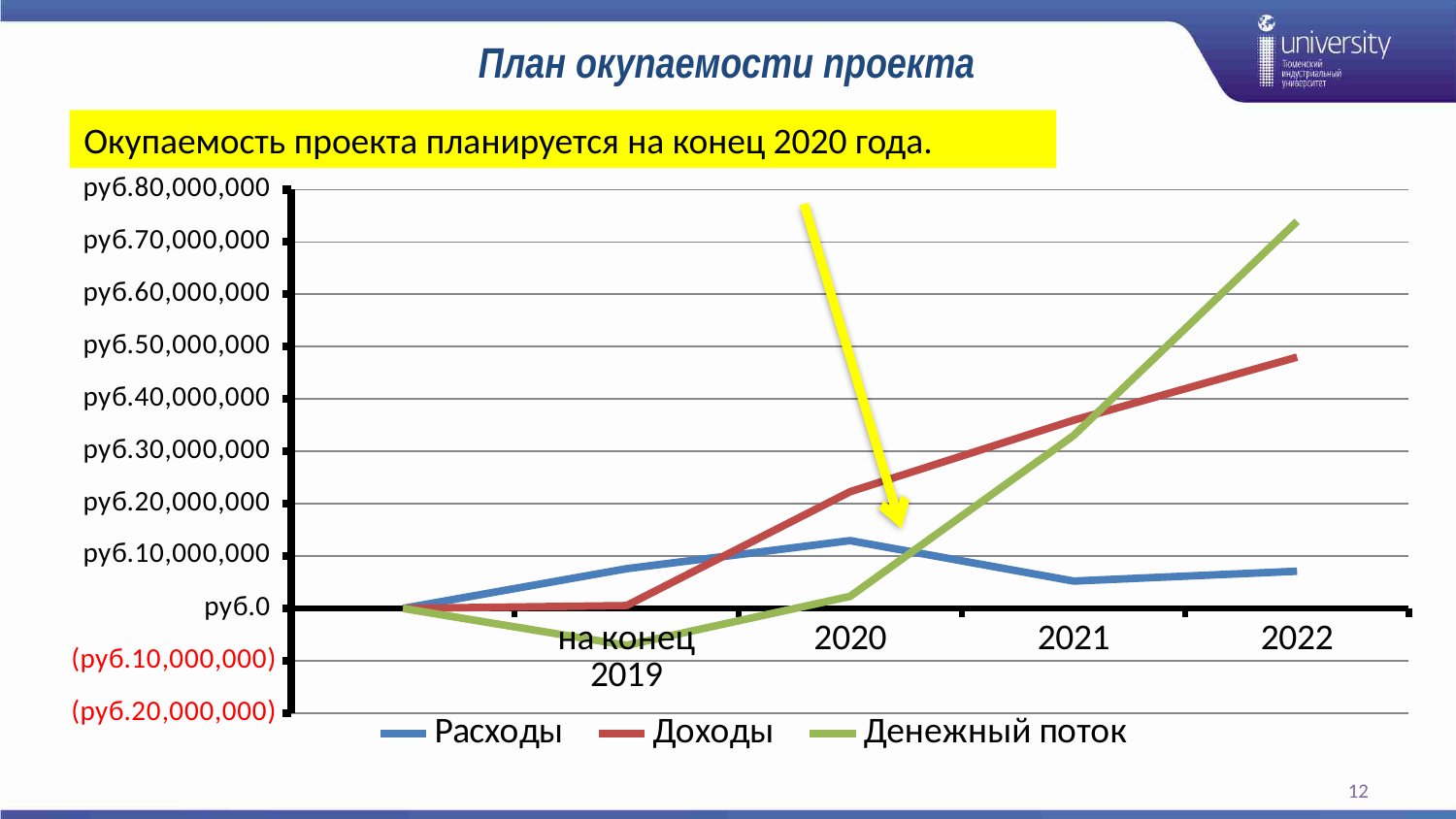
Is the value of Денежный поток in 2022 greater or less than руб.60,000,000? greater Does the Доходы line rise or fall from 'на конец 2019' to 2022? rise In which year does the Расходы line reach its highest value? 2020 What kind of chart is shown on the slide? line chart What are the three series named in the legend? Расходы, Доходы, Денежный поток Is the value of Денежный поток at 'на конец 2019' greater or less than руб.0? less Is the value of Доходы in 2022 greater or less than руб.40,000,000? greater Which series has the highest value in 2022? Денежный поток In 2020, which is larger: Доходы or Расходы? Доходы What is the title of the slide containing the chart? План окупаемости проекта How many series does the legend list? 3